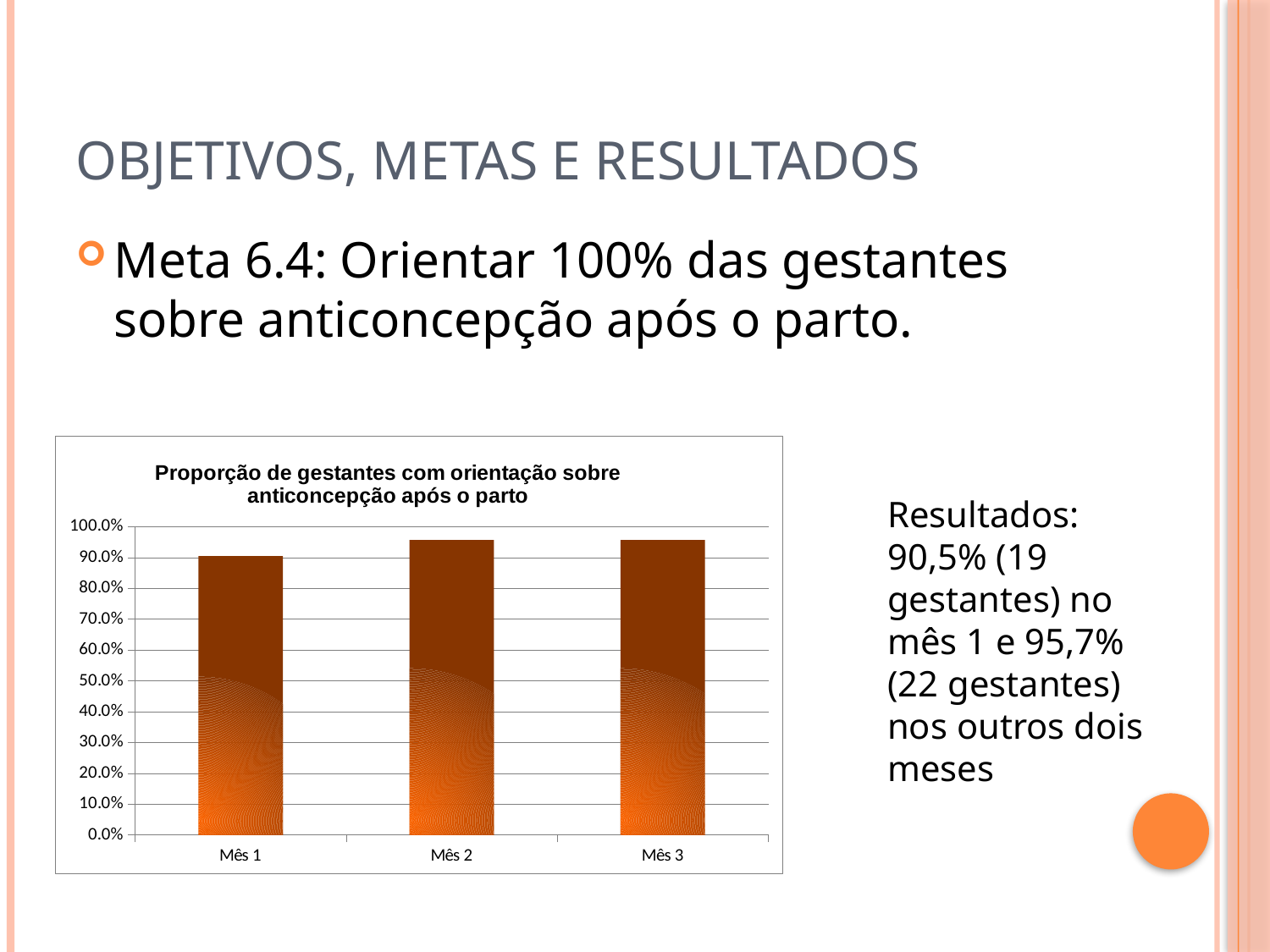
Which month has the lowest bar in the chart? Mês 1 Which is larger in the chart, the value for Mês 1 or the value for Mês 2? Mês 2 What kind of chart is shown on the slide? bar chart Is the value for Mês 3 greater or less than 90.0%? greater Does the value rise or fall from Mês 1 to Mês 2? rise Is the value for Mês 2 greater or less than 100.0%? less What is the highest tick label on the y axis of the chart? 100.0% How many categories (months) are shown on the x axis of the chart? 3 What is the title of the chart? Proporção de gestantes com orientação sobre anticoncepção após o parto Is the value for Mês 1 greater or less than 100.0%? less